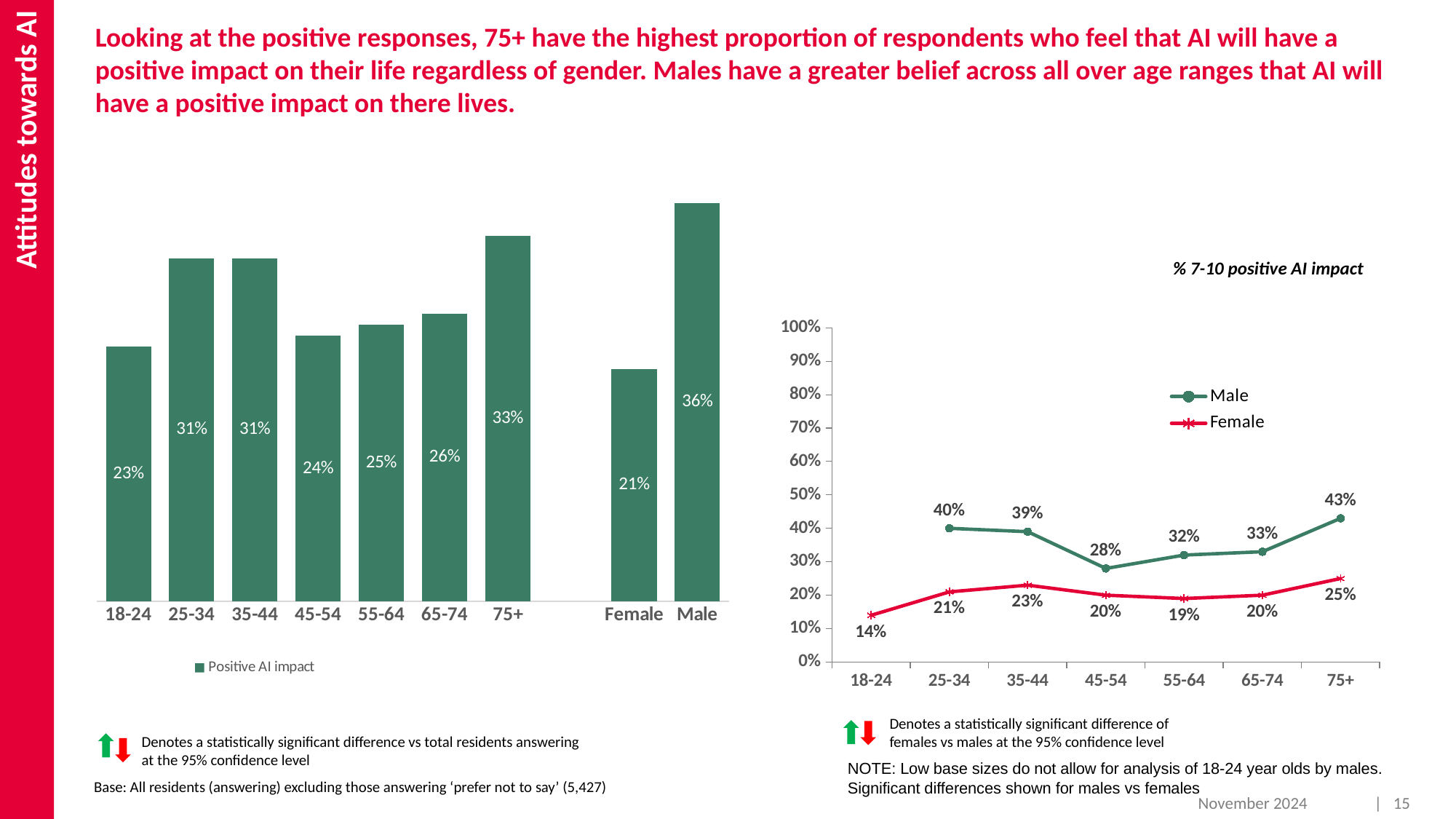
In the bar chart on the left, what is the value for the 25-34 age group? 31% In the '% 7-10 positive AI impact' chart, which age group has the highest Male value? 75+ In the '% 7-10 positive AI impact' chart, what is the Female value for 18-24? 14% In the bar chart on the left, how many bars are plotted? 9 In the '% 7-10 positive AI impact' chart, how many series does the legend list? 2 What type of chart is the chart on the left? Bar chart In the bar chart on the left, what is the value for Female? 21% In the bar chart on the left, which age group has the lowest value? 18-24 In the '% 7-10 positive AI impact' chart, what is the difference between the Male and Female values for 75+? 18 percentage points In the bar chart on the left, what is the difference between the Male and Female values? 15 percentage points What type of chart is the '% 7-10 positive AI impact' chart? Line chart In the '% 7-10 positive AI impact' chart, what is the Male value for 45-54? 28%